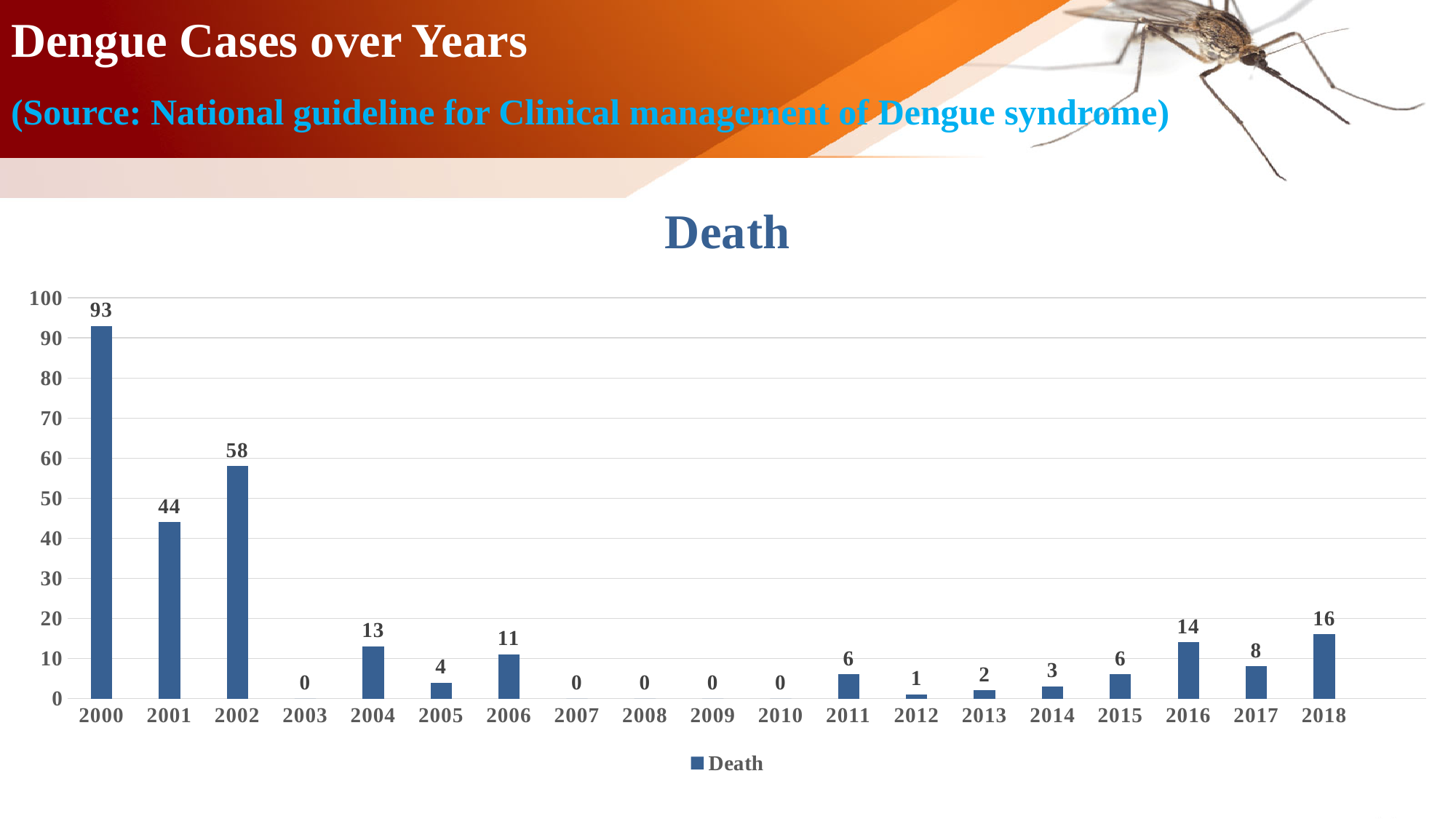
Is the value for 2002 greater or less than 50? greater How many years are shown on the x axis? 19 How many years show 0 deaths? 5 Which year has more deaths, 2004 or 2006? 2004 What is the difference in deaths between 2000 and 2001? 49 What is the title of the chart? Death What is the number of deaths in 2000? 93 What kind of chart is shown on the slide? Bar chart What is the difference in deaths between 2016 and 2017? 6 What is the number of deaths in 2002? 58 What is the number of deaths in 2018? 16 Which year has the highest number of deaths? 2000